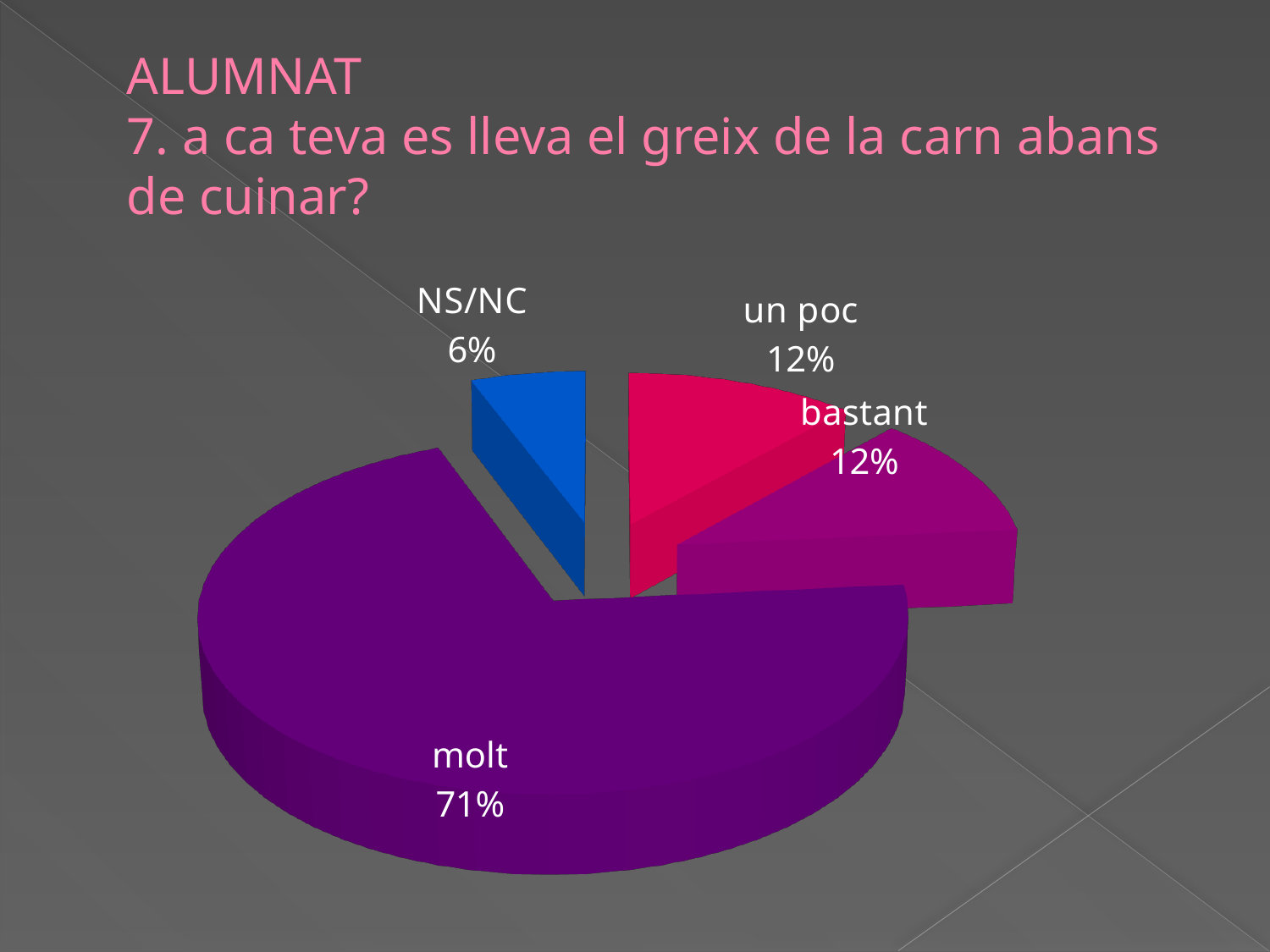
What kind of chart is shown on the slide? pie chart What is the difference between the "bastant" share and the "NS/NC" share? 6% What is the difference between the "molt" share and the "un poc" share? 59% What colour is the "NS/NC" slice? blue How many slices does the pie chart have? 4 What is the value shown for "NS/NC"? 6% What is the value shown for "un poc"? 12% What is the value shown for "bastant"? 12% Which category has the largest slice of the pie? molt Which is larger, the share for "molt" or the share for "bastant"? molt Which category has the smallest slice of the pie? NS/NC What share of the pie does the "molt" slice represent? 71%